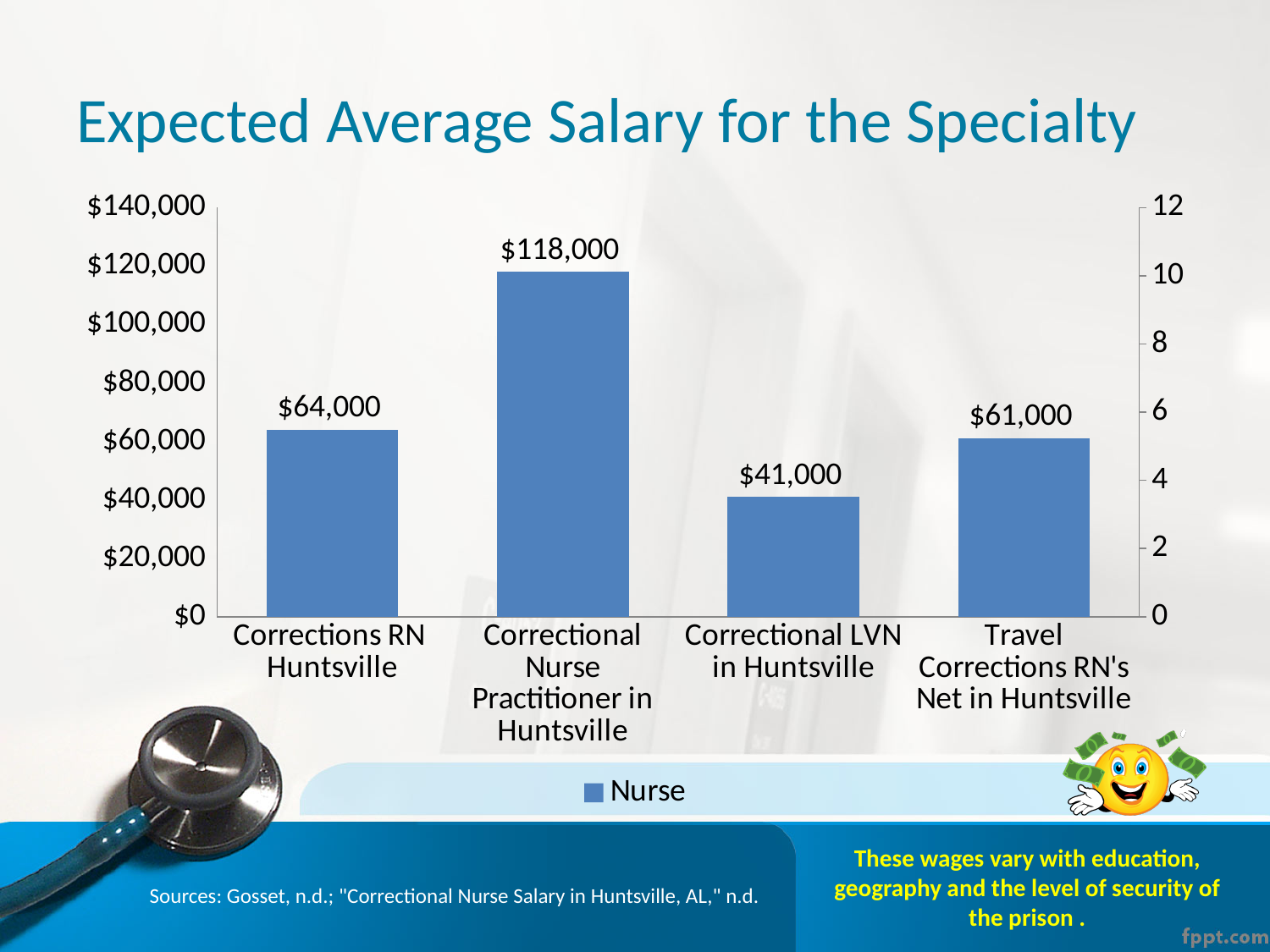
Which is larger: the salary for Corrections RN Huntsville or for Correctional LVN in Huntsville? Corrections RN Huntsville Which category has the highest expected average salary? Correctional Nurse Practitioner in Huntsville What is the expected average salary for Travel Corrections RN's Net in Huntsville? $61,000 How many categories are shown on the chart? 4 What is the difference between the salary for Correctional Nurse Practitioner in Huntsville and Correctional LVN in Huntsville? $77,000 What is the expected average salary for Correctional Nurse Practitioner in Huntsville? $118,000 Which category has the lowest expected average salary? Correctional LVN in Huntsville What is the expected average salary for Corrections RN Huntsville? $64,000 What kind of chart is shown on the slide? Bar chart What is the difference between the salary for Corrections RN Huntsville and Travel Corrections RN's Net in Huntsville? $3,000 What is the expected average salary for Correctional LVN in Huntsville? $41,000 What series name does the legend show? Nurse